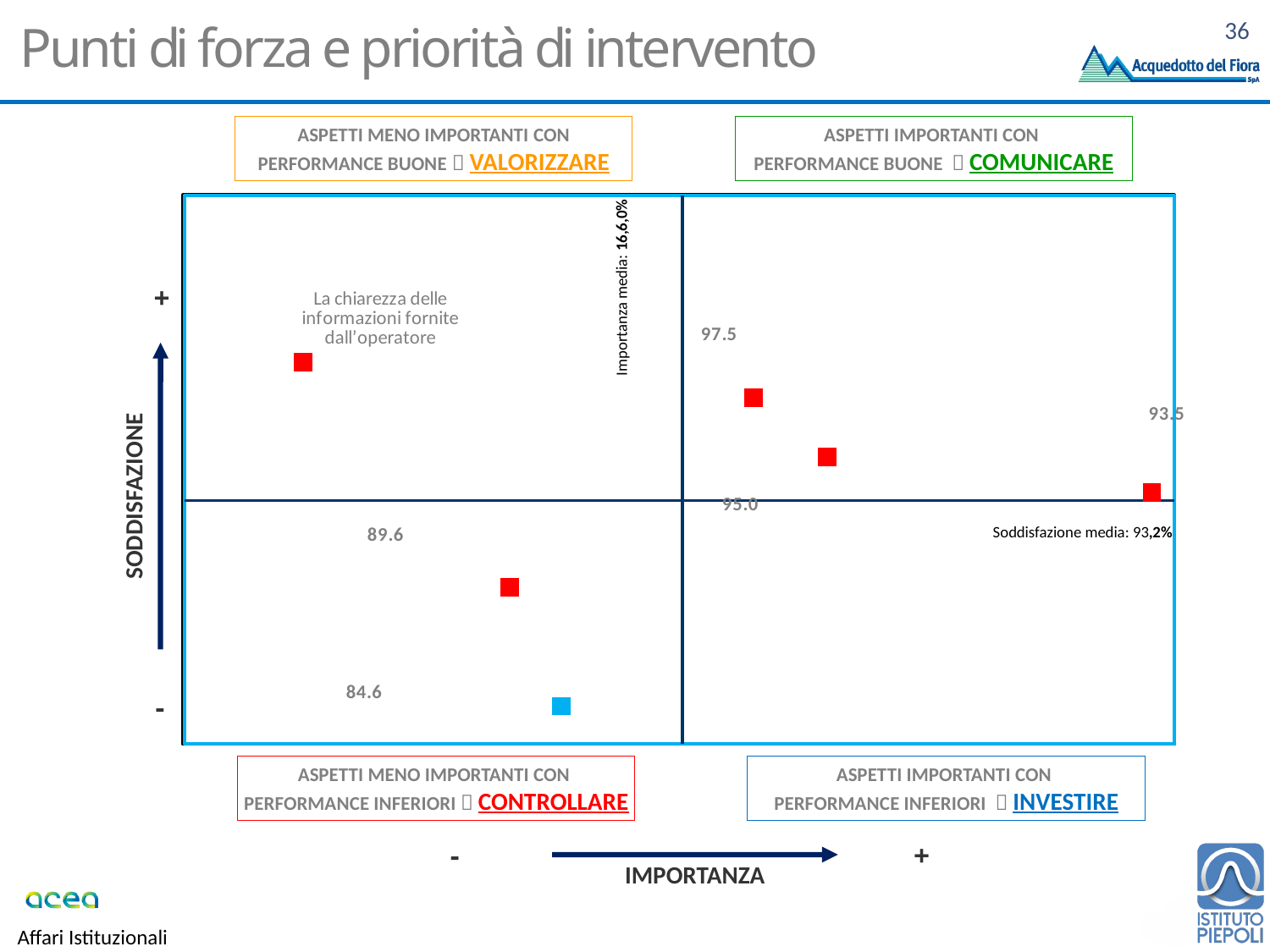
What is the highest satisfaction value printed as a data label on the chart? 97.5 What is the difference between the data labels 97.5 and 84.6 on the chart? 12.9 How many data points are plotted in the chart? 6 What kind of chart is shown on the slide? scatter chart What is the average satisfaction (Soddisfazione media) shown on the chart? 93,2% What is the lowest satisfaction value printed as a data label on the chart? 84.6 Is the point labelled 'La chiarezza delle informazioni fornite dall'operatore' above or below the average satisfaction line? above In which quadrant does the point 'La chiarezza delle informazioni fornite dall'operatore' fall? Aspetti meno importanti con performance buone (VALORIZZARE) What label is on the horizontal axis of the chart? IMPORTANZA Which is larger, the data label 89.6 or the data label 93.5? 93.5 What label is on the vertical axis of the chart? SODDISFAZIONE